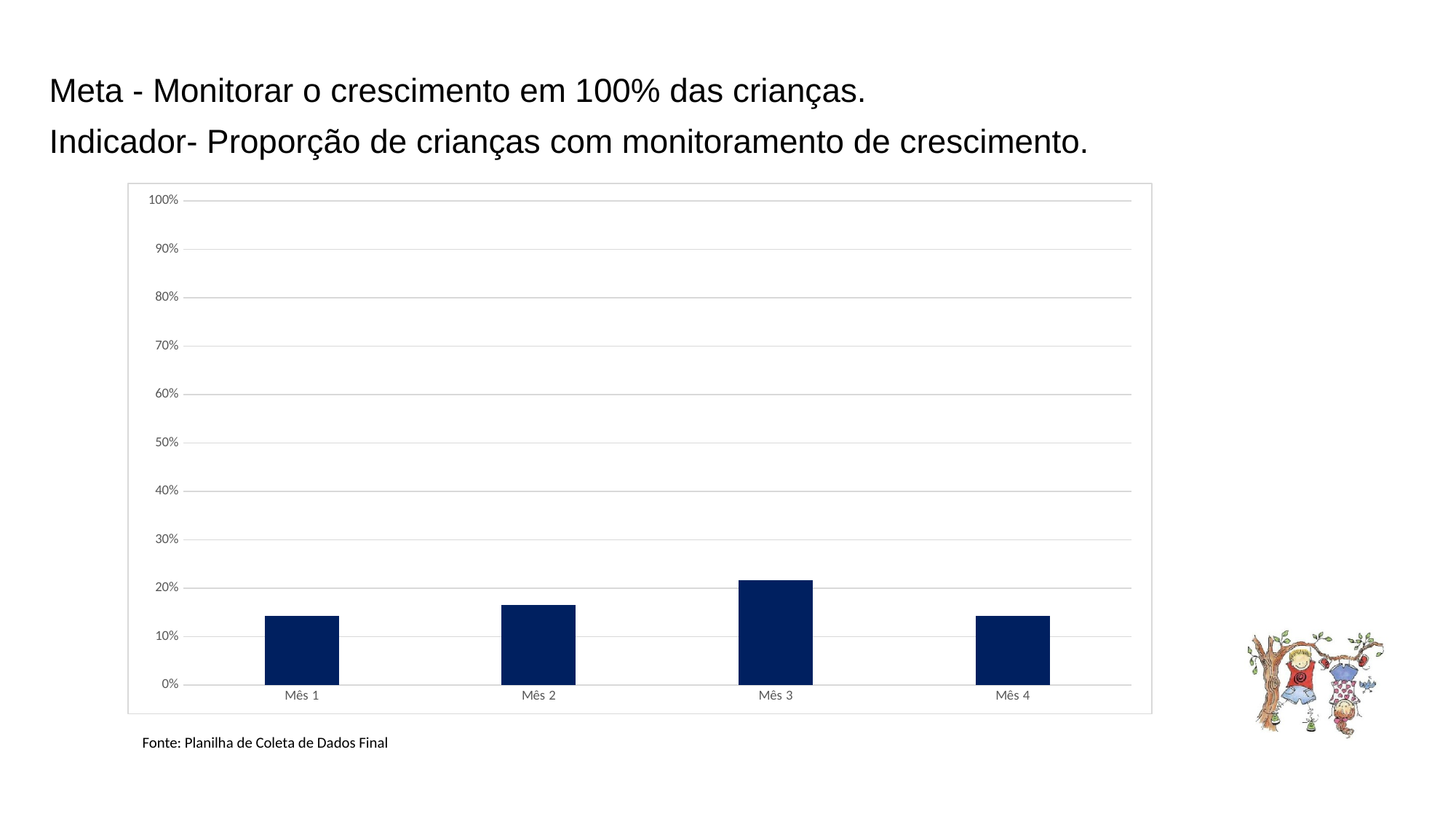
Is the value for Mês 4 greater or less than 20%? less How many months (categories) are plotted on the x axis of the chart? 4 What is the highest value shown on the chart's vertical axis? 100% Is the value for Mês 2 greater or less than 20%? less Is the value for Mês 3 greater or less than 30%? less Which is larger, the value for Mês 3 or the value for Mês 2? Mês 3 What source is cited below the chart? Planilha de Coleta de Dados Final Which is larger, the value for Mês 2 or the value for Mês 1? Mês 2 What kind of chart is shown on the slide? Bar chart Which month has the highest proportion of children with growth monitoring? Mês 3